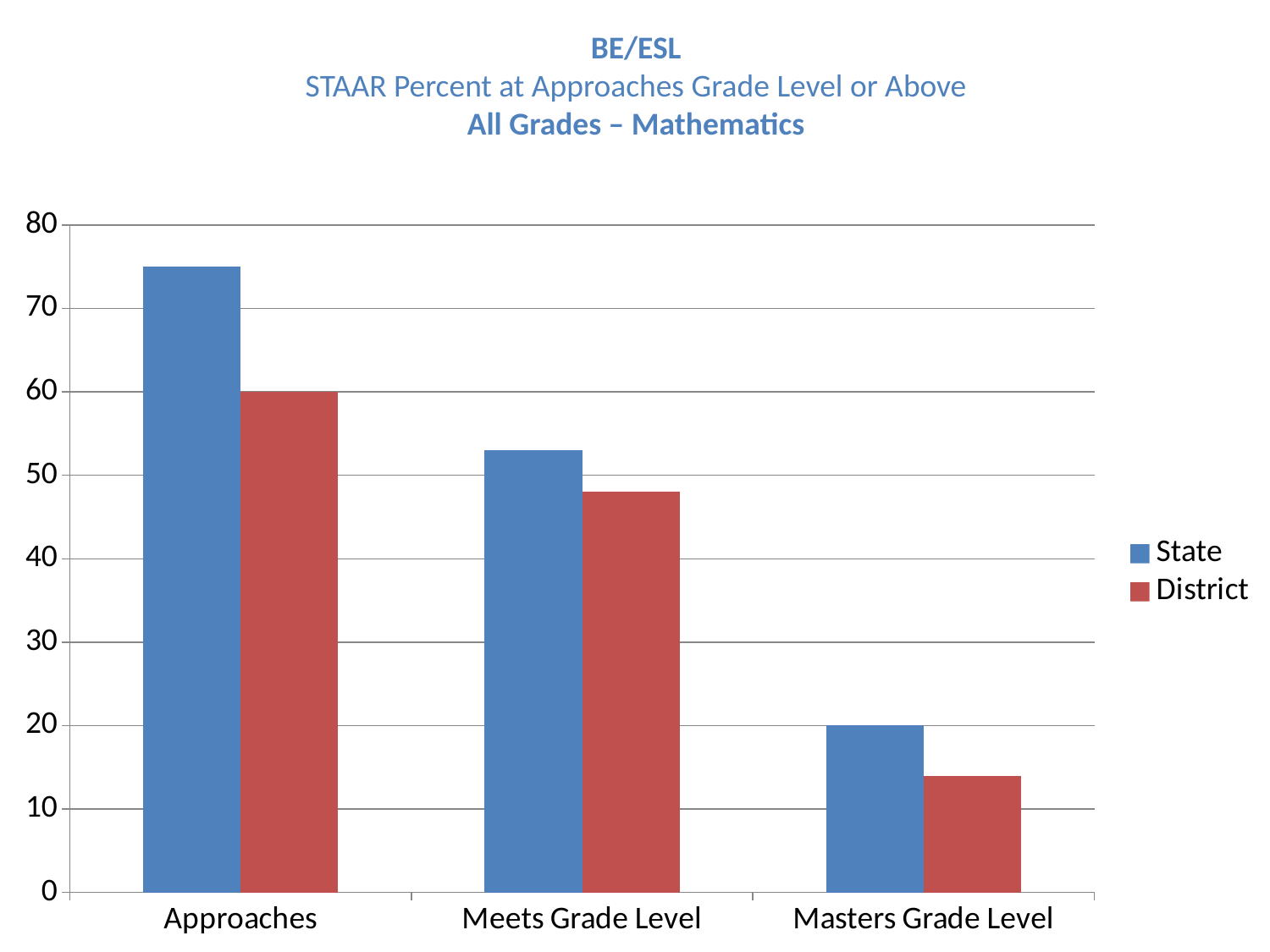
How many series does the legend list? 2 What type of chart is shown on the slide? bar chart Is the District value for Meets Grade Level greater or less than 50? less For Meets Grade Level, which is larger, State or District? State Is the State value for Approaches greater or less than 70? greater Is the District value for Masters Grade Level greater or less than 10? greater Which bar is the highest in the chart? State, Approaches What is the State value for Masters Grade Level? 20 Do the State values rise or fall from Approaches to Masters Grade Level? fall How many categories are shown on the x axis? 3 Which bar is the lowest in the chart? District, Masters Grade Level What is the District value for Approaches? 60